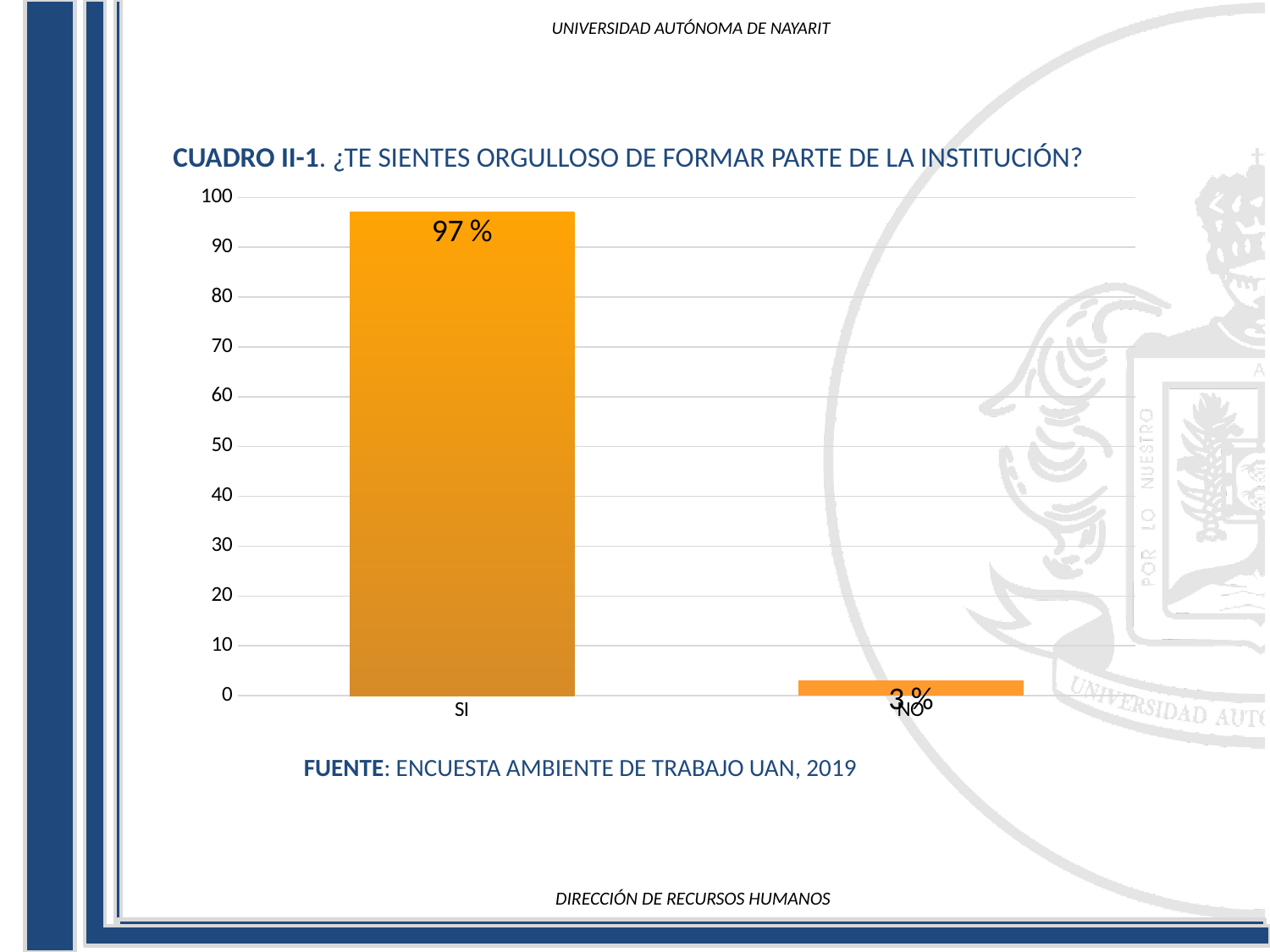
What kind of chart is shown on the slide? bar chart What is the title of the chart? CUADRO II-1. ¿TE SIENTES ORGULLOSO DE FORMAR PARTE DE LA INSTITUCIÓN? Which category has the highest value? SI Which is larger, the value for SI or the value for NO? SI What is the difference between the values for SI and NO? 94 % What source is cited below the chart? ENCUESTA AMBIENTE DE TRABAJO UAN, 2019 Which category has the lowest value? NO What is the value for SI? 97 % How many categories are shown on the chart? 2 Is the value for NO greater or less than 10? less Is the value for SI greater or less than 90? greater What is the value for NO? 3 %